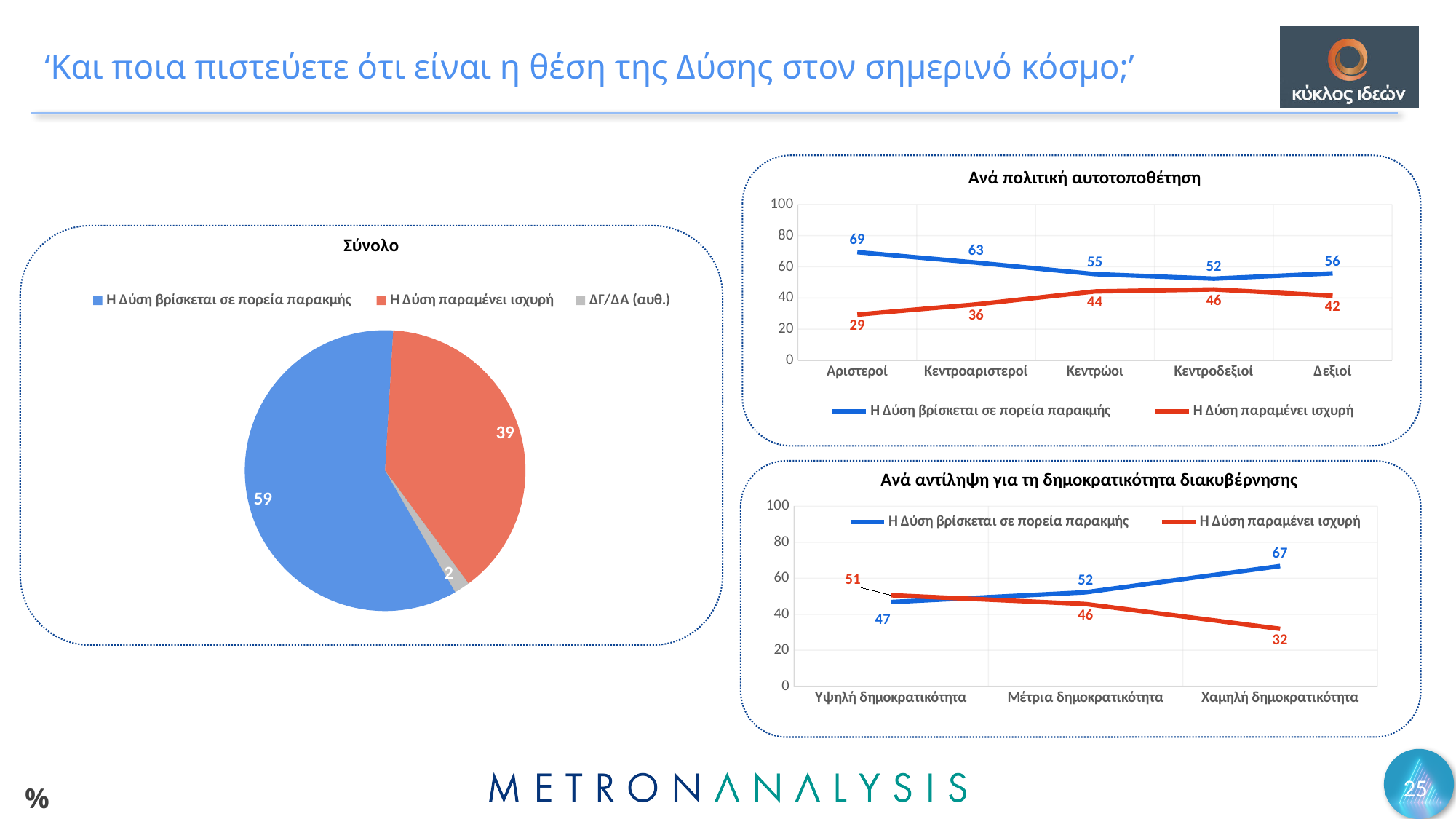
What kind of chart is the 'Σύνολο' chart? pie chart How many series does the legend of the 'Ανά αντίληψη για τη δημοκρατικότητα διακυβέρνησης' chart list? 2 How many categories are shown on the x axis of the 'Ανά πολιτική αυτοτοποθέτηση' chart? 5 In the 'Ανά αντίληψη για τη δημοκρατικότητα διακυβέρνησης' chart, what is the value of 'Η Δύση βρίσκεται σε πορεία παρακμής' for 'Χαμηλή δημοκρατικότητα'? 67 In the 'Ανά αντίληψη για τη δημοκρατικότητα διακυβέρνησης' chart, which series has the larger value for 'Μέτρια δημοκρατικότητα'? Η Δύση βρίσκεται σε πορεία παρακμής In the 'Σύνολο' chart, what value is shown for 'Η Δύση βρίσκεται σε πορεία παρακμής'? 59 In the 'Ανά πολιτική αυτοτοποθέτηση' chart, what is the value of 'Η Δύση παραμένει ισχυρή' for 'Κεντρώοι'? 44 In the 'Σύνολο' chart, what is the difference between 'Η Δύση βρίσκεται σε πορεία παρακμής' and 'Η Δύση παραμένει ισχυρή'? 20 In the 'Ανά πολιτική αυτοτοποθέτηση' chart, what is the difference between the two series for 'Δεξιοί'? 14 In the 'Ανά πολιτική αυτοτοποθέτηση' chart, which category has the highest value for 'Η Δύση βρίσκεται σε πορεία παρακμής'? Αριστεροί In the 'Ανά αντίληψη για τη δημοκρατικότητα διακυβέρνησης' chart, does 'Η Δύση παραμένει ισχυρή' rise or fall from 'Υψηλή δημοκρατικότητα' to 'Χαμηλή δημοκρατικότητα'? fall In the 'Σύνολο' chart, which category has the smallest slice? ΔΓ/ΔΑ (αυθ.)